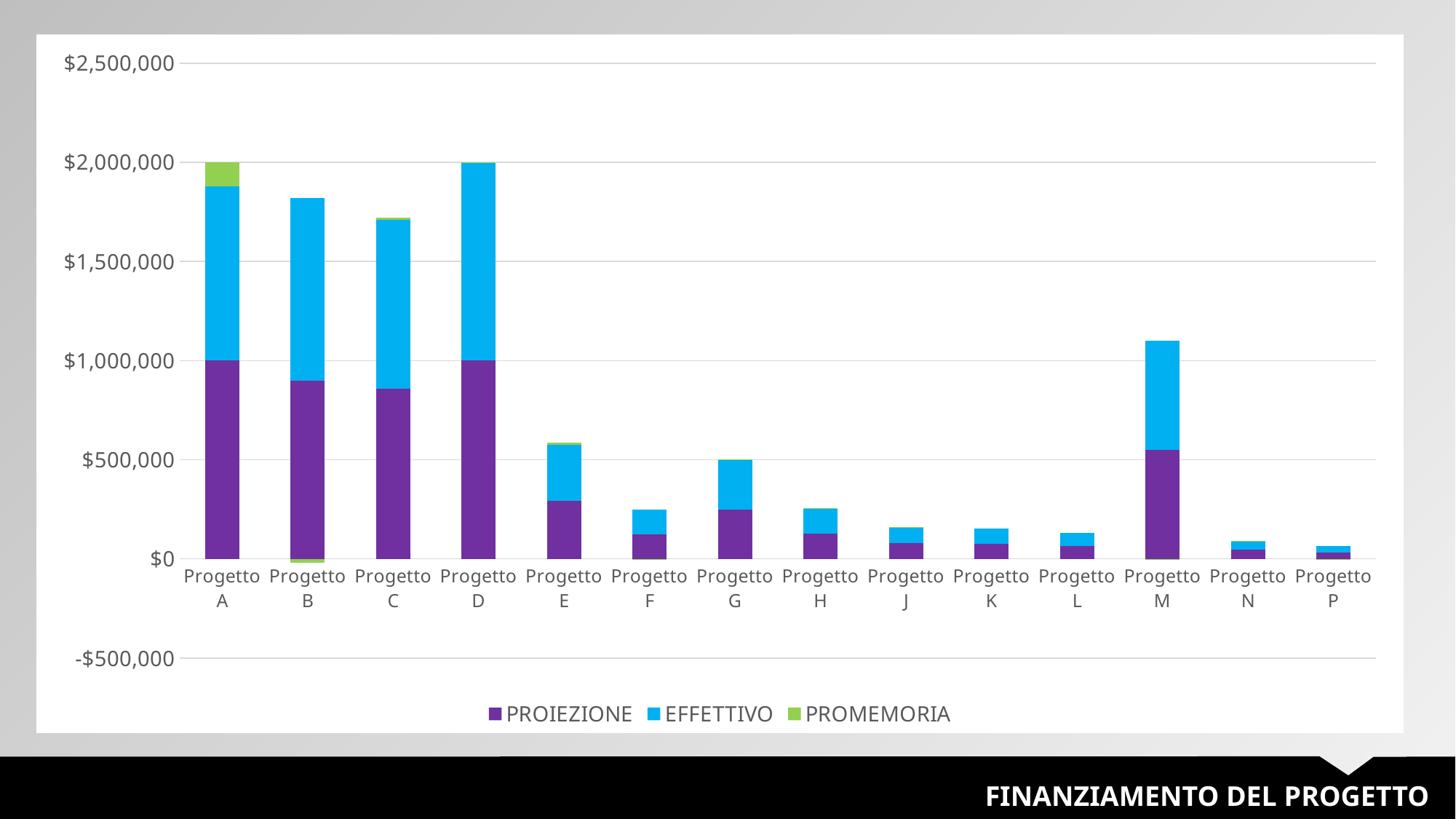
How many series does the legend list? 3 Which project has the lowest total stacked bar? Progetto P Is the PROIEZIONE value for Progetto C greater or less than $1,000,000? less What is the title shown at the bottom of the slide? FINANZIAMENTO DEL PROGETTO Is the total value for Progetto B greater or less than $1,500,000? greater What are the three series named in the legend? PROIEZIONE, EFFETTIVO, PROMEMORIA How many projects (categories) are shown on the x axis? 14 Which has the larger total stacked bar, Progetto M or Progetto G? Progetto M Is the total value for Progetto M greater or less than $1,000,000? greater Which has the larger total stacked bar, Progetto B or Progetto E? Progetto B What kind of chart is shown on the slide? Stacked bar chart